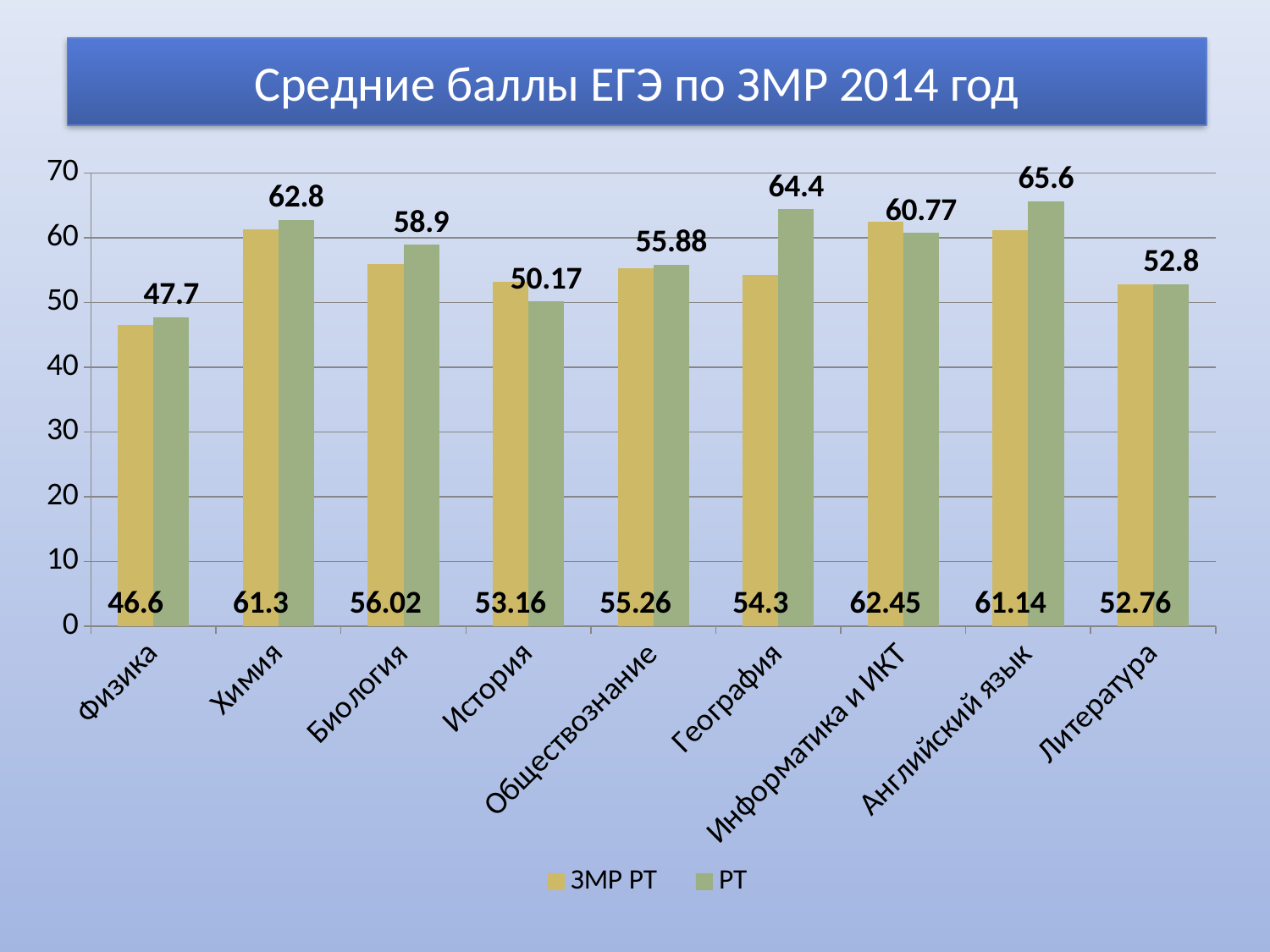
For Информатика и ИКТ, which is larger: the ЗМР РТ value or the РТ value? ЗМР РТ What is the РТ value for Английский язык? 65.6 What is the ЗМР РТ value for Физика? 46.6 What is the difference between the РТ and ЗМР РТ values for География? 10.1 What is the difference between the ЗМР РТ and РТ values for История? 2.99 How many series does the legend list? 2 Which category has the highest РТ value? Английский язык How many categories are shown on the x axis? 9 What is the ЗМР РТ value for Информатика и ИКТ? 62.45 Which category has the lowest ЗМР РТ value? Физика What kind of chart is shown on the slide? bar chart Is the РТ value for Химия greater or less than 60? greater